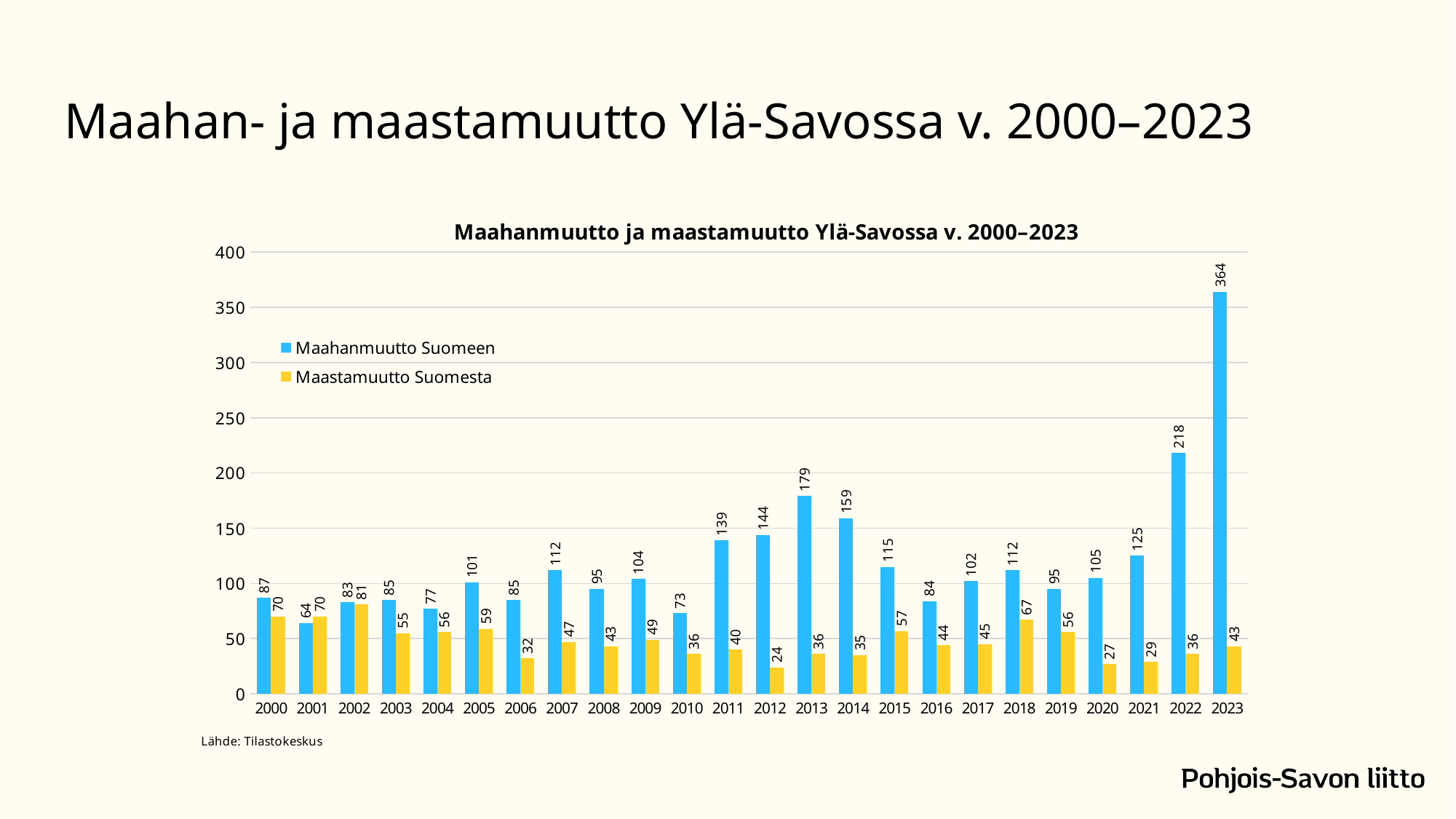
How many series does the legend list? 2 What is the value of Maastamuutto Suomesta in 2018? 67 What type of chart is shown on the slide? bar chart Which year has the lowest value for Maahanmuutto Suomeen? 2001 Which is larger in 2001: Maahanmuutto Suomeen or Maastamuutto Suomesta? Maastamuutto Suomesta How many years are shown on the x axis? 24 What is the difference between Maahanmuutto Suomeen and Maastamuutto Suomesta in 2023? 321 Which year has the lowest value for Maastamuutto Suomesta? 2012 What is the title of the chart? Maahanmuutto ja maastamuutto Ylä-Savossa v. 2000–2023 Which year has the highest value for Maastamuutto Suomesta? 2002 Which year has the highest value for Maahanmuutto Suomeen? 2023 What is the value of Maahanmuutto Suomeen in 2013? 179